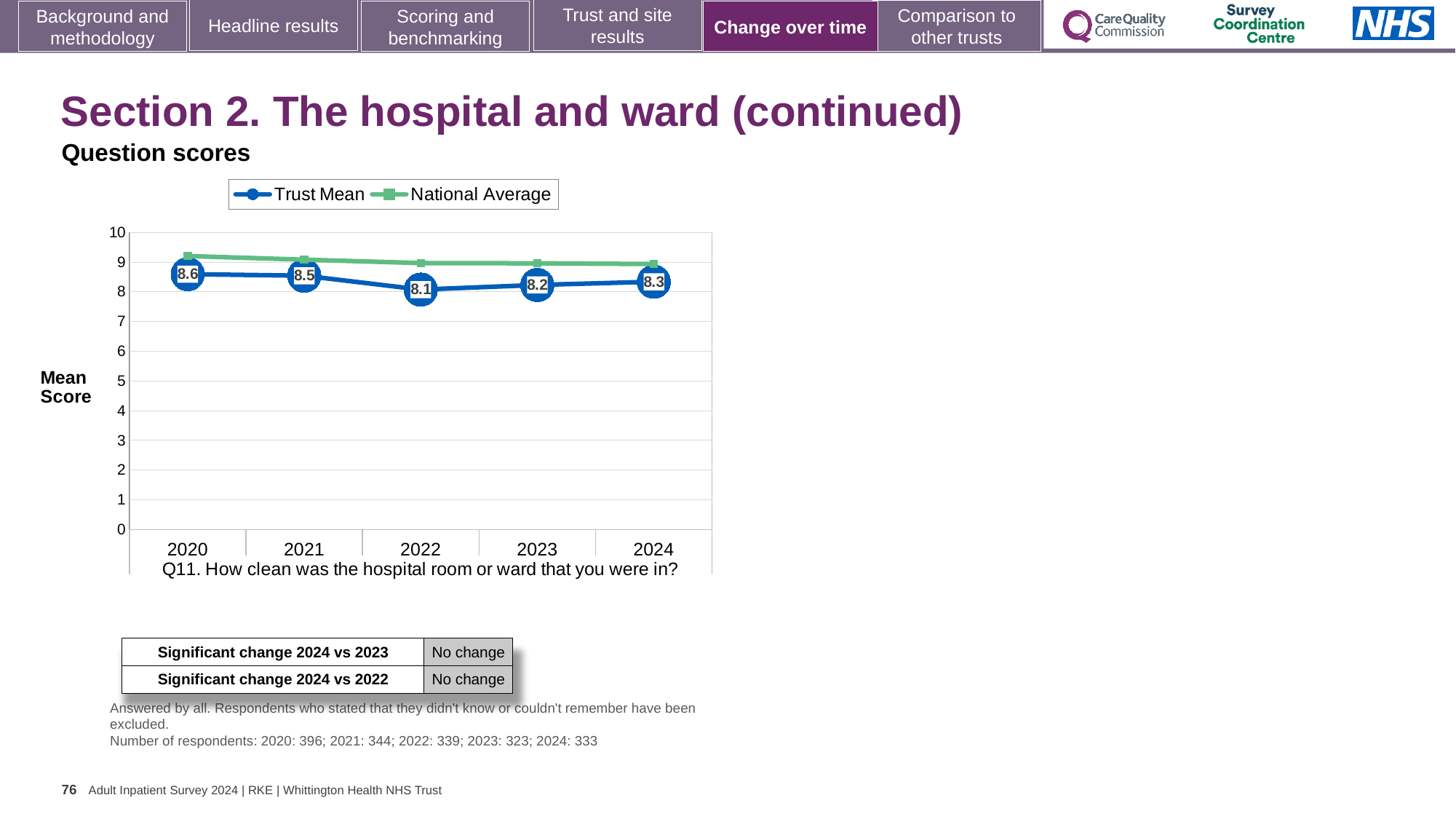
What is the difference between the Trust Mean scores for 2020 and 2022? 0.5 In which year is the Trust Mean score lowest? 2022 In which year is the Trust Mean score highest? 2020 How many series does the legend list? 2 How many years are shown on the x axis? 5 Which question does the chart relate to, as labelled below the x axis? Q11. How clean was the hospital room or ward that you were in? Is the National Average value for 2020 greater or less than 9? greater What is the Trust Mean score for 2024? 8.3 Which is larger, the Trust Mean score for 2021 or for 2023? 2021 What is the Trust Mean score for 2022? 8.1 What is the Trust Mean score for 2020? 8.6 What kind of chart is shown on the slide? Line chart